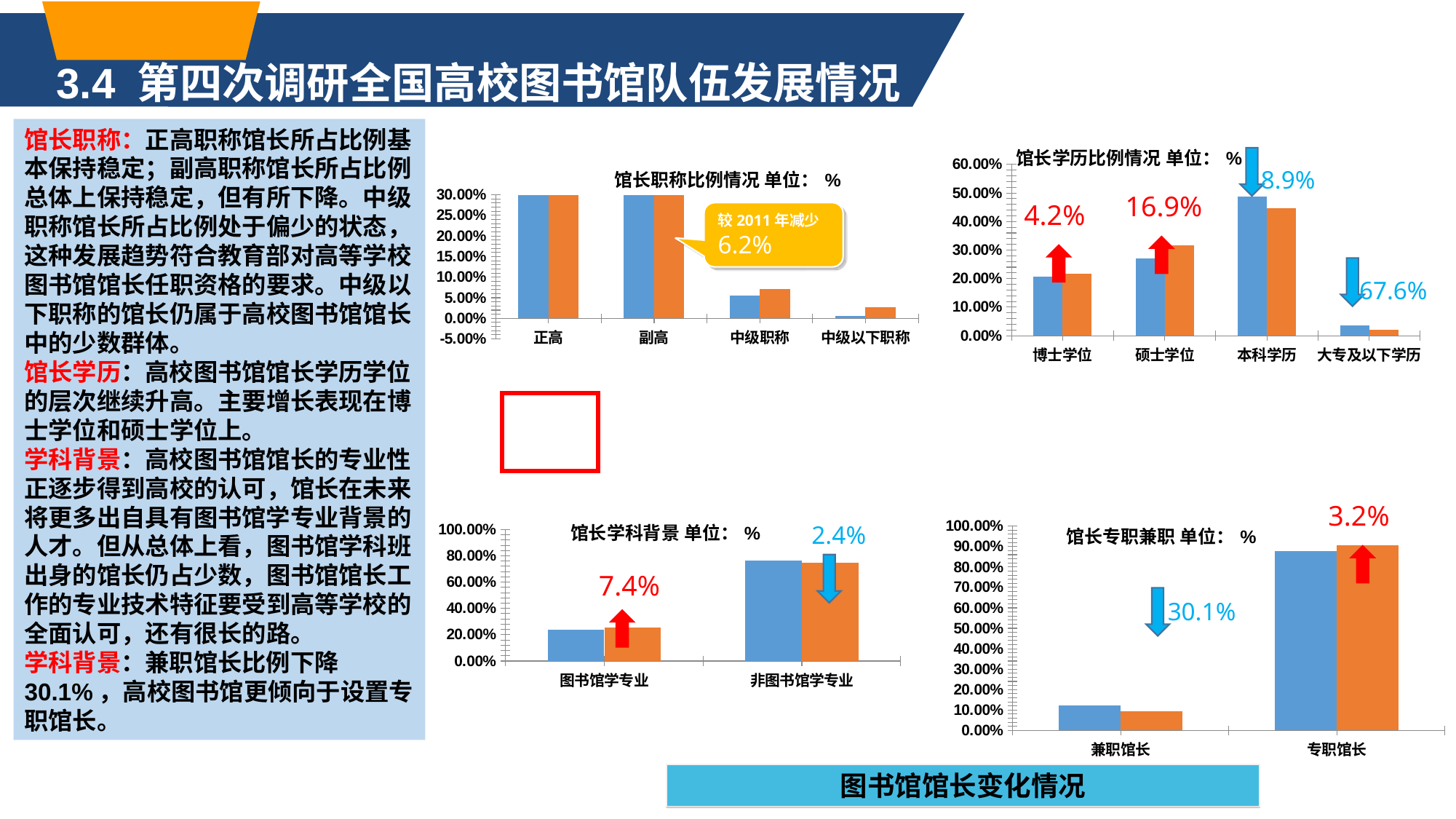
In the 馆长学历比例情况 chart, is the blue bar for 本科学历 greater or less than 40.00%? greater In the 馆长学科背景 chart, which category has the higher bars? 非图书馆学专业 In the 馆长职称比例情况 chart, which category has the lowest bars? 中级以下职称 How many categories are shown on the x axis of the 馆长学历比例情况 chart? 4 In the 馆长学历比例情况 chart, which is larger for 硕士学位: the blue bar or the orange bar? the orange bar In the 馆长学科背景 chart, is the blue bar for 图书馆学专业 greater or less than 40.00%? less In the 馆长学历比例情况 chart, which category has the highest bars? 本科学历 In the 馆长职称比例情况 chart, is the orange bar for 中级职称 greater or less than 10.00%? less What kind of chart is the 馆长职称比例情况 chart? bar chart How many categories are shown on the x axis of the 馆长职称比例情况 chart? 4 What is the title of the chart in the bottom-right of the slide? 馆长专职兼职 单位：%